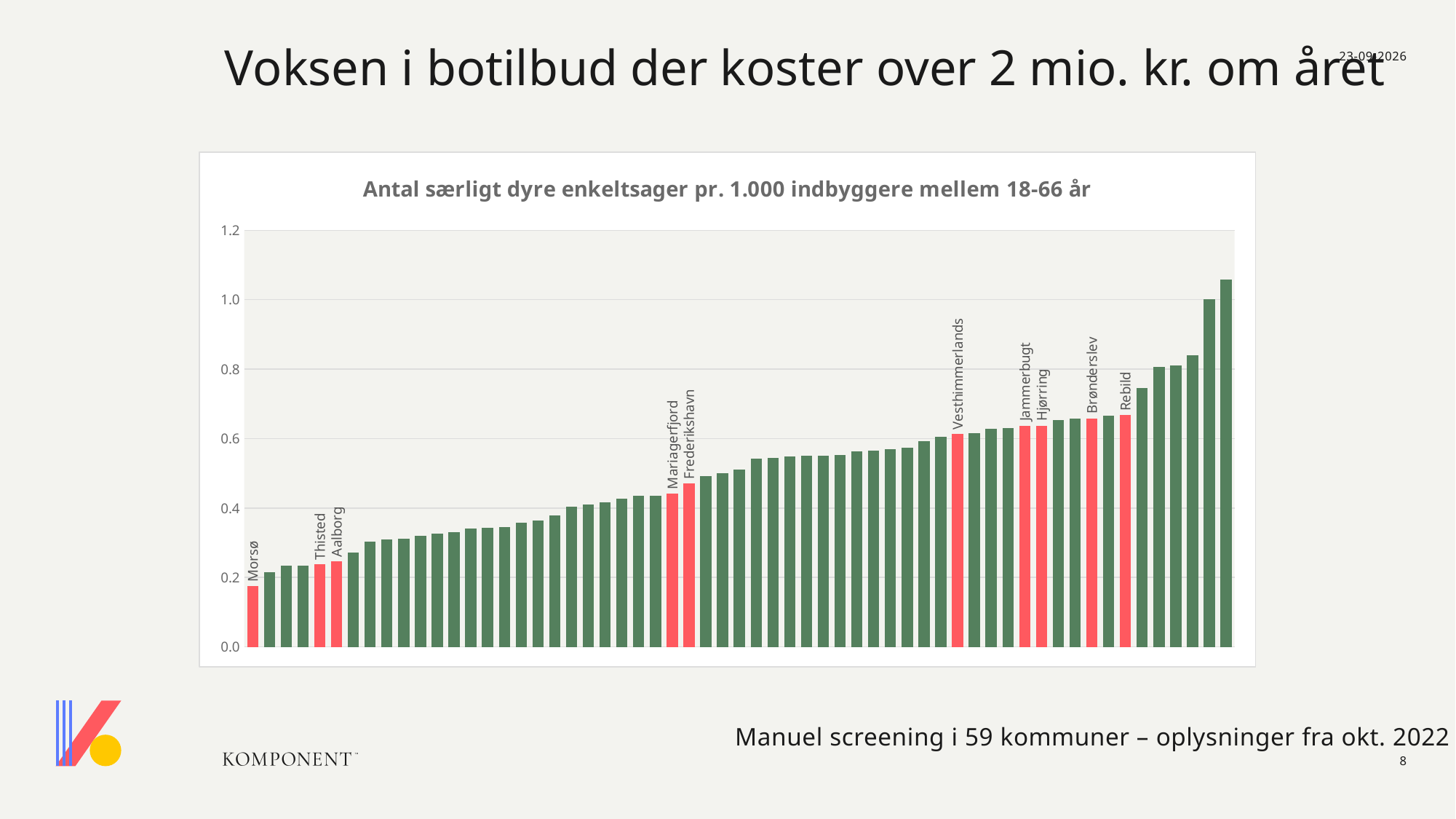
Which of the labelled municipalities has the lowest value? Morsø Is the value for Mariagerfjord greater or less than 0.4? greater Is the value for Rebild greater or less than 0.8? less Do the bar values rise or fall from left to right along the x axis? Rise What is the title of the chart? Antal særligt dyre enkeltsager pr. 1.000 indbyggere mellem 18-66 år Which has the larger value, Aalborg or Mariagerfjord? Mariagerfjord Is the value for Thisted greater or less than 0.2? greater How many bars are highlighted in red with a municipality name? 10 What kind of chart is shown on the slide? Bar chart